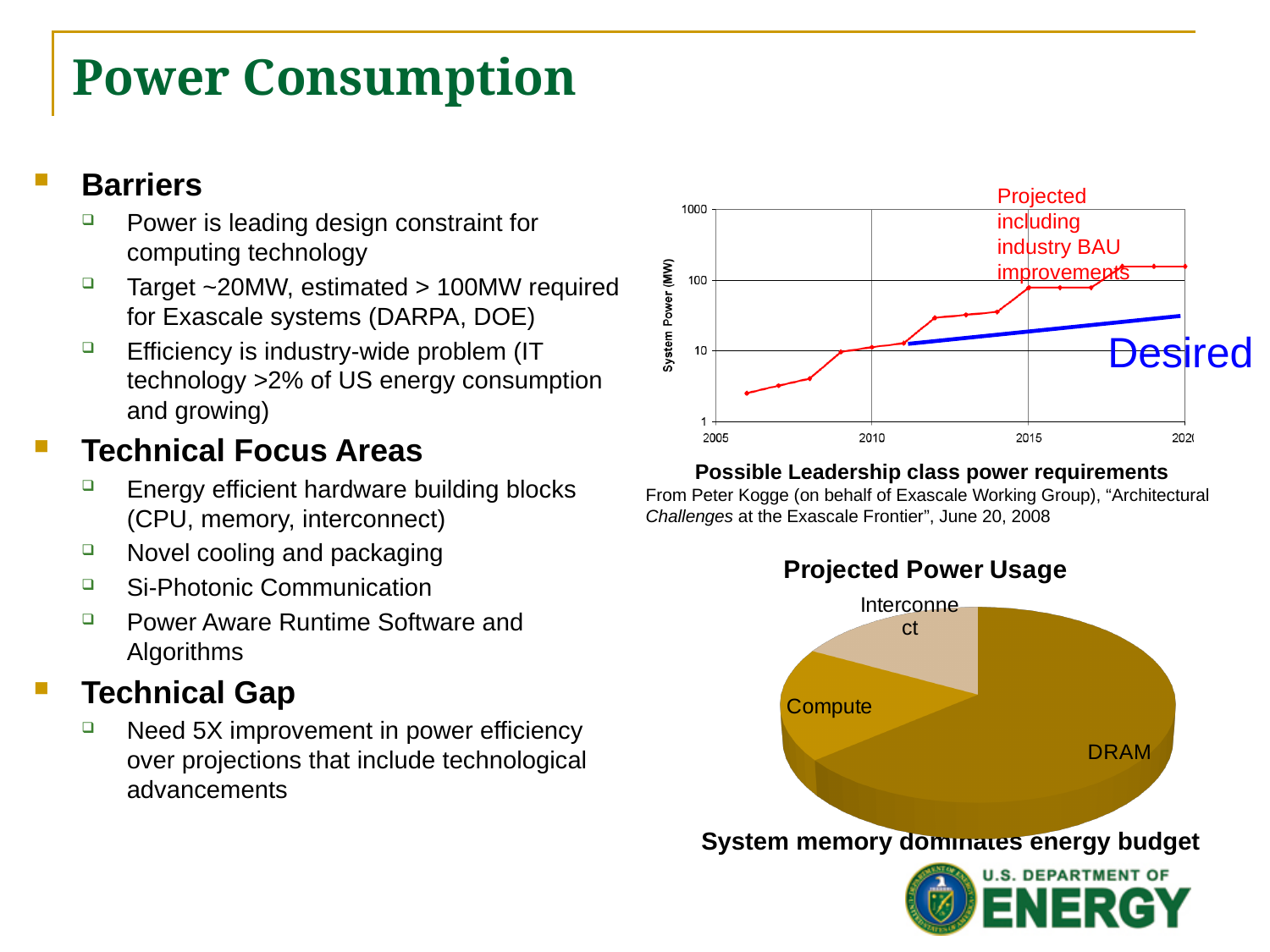
In the 'Projected Power Usage' pie chart, which category has the largest slice? DRAM What is the label of the y axis in the 'Possible Leadership class power requirements' chart? System Power (MW) What kind of chart is the 'Possible Leadership class power requirements' chart? line chart How many slices does the 'Projected Power Usage' pie chart have? 3 What kind of chart is the 'Projected Power Usage' chart? pie chart In the 'Possible Leadership class power requirements' chart, is the red projected value at 2020 greater or less than 100 MW? greater In the 'Possible Leadership class power requirements' chart, is the blue 'Desired' line value at 2020 greater or less than 100 MW? less In the 'Possible Leadership class power requirements' chart, does the red projected line rise or fall from 2005 to 2020? rise What is the caption printed below the 'Projected Power Usage' pie chart? System memory dominates energy budget In the 'Projected Power Usage' pie chart, which slice is larger, Compute or DRAM? DRAM In the 'Possible Leadership class power requirements' chart, is the red projected value at 2006 greater or less than 10 MW? less